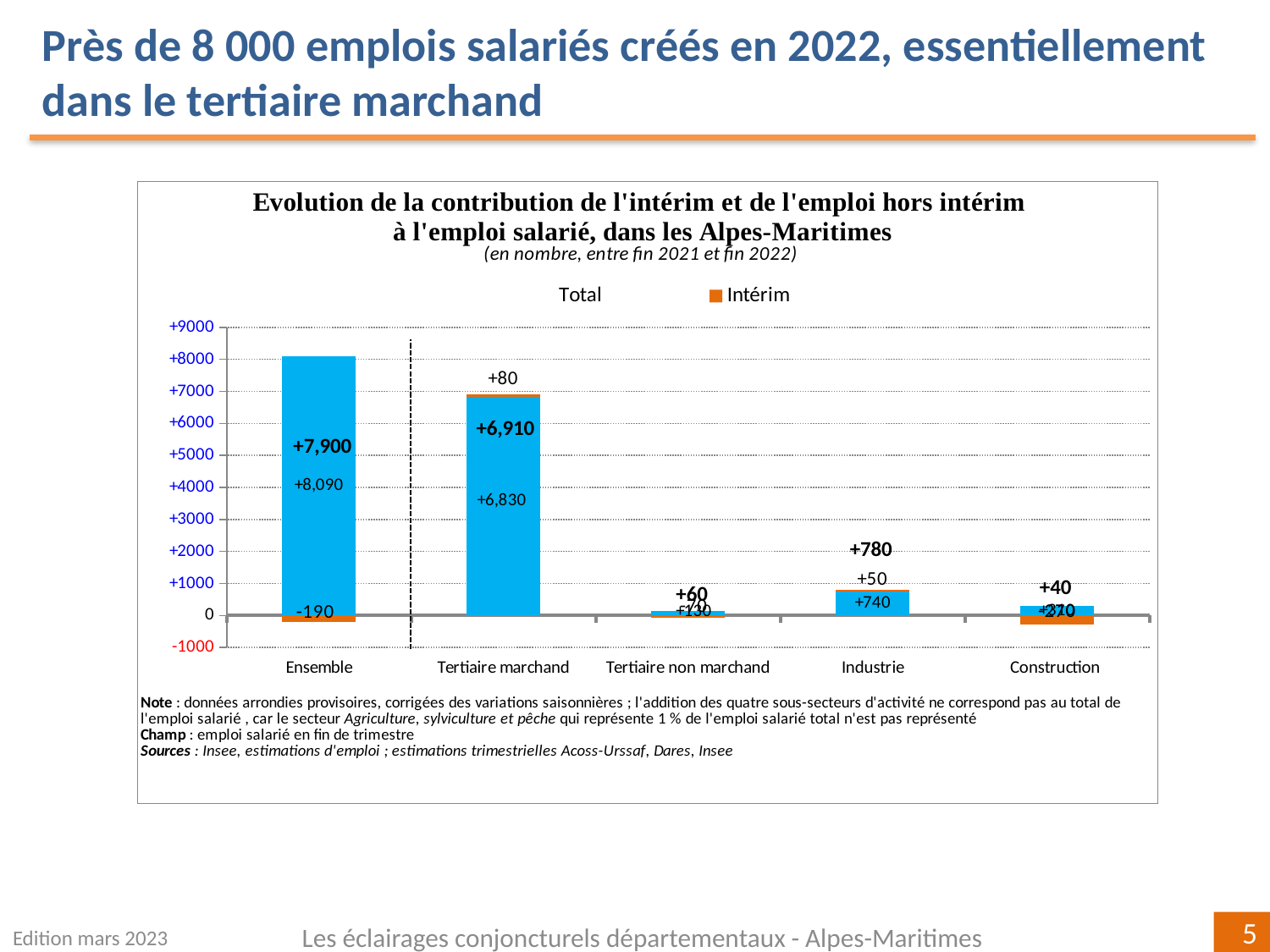
What is the Intérim value shown for Ensemble? -190 Which has the larger total value, Industrie or Construction? Industrie How many categories are shown along the x axis of the chart? 5 How many series does the chart legend list? 2 What is the difference between the total value for Ensemble (+7,900) and the total value for Tertiaire marchand (+6,910)? 990 What is the total value (bold label) shown for Industrie? +780 What kind of chart is shown on the slide? bar chart Among the four sub-sectors (excluding Ensemble), which has the highest total value? Tertiaire marchand What is the Intérim value shown for Industrie? +50 What is the total value (bold label) shown for Ensemble? +7,900 What is the total value (bold label) shown for Tertiaire marchand? +6,910 What is the Intérim value shown for Tertiaire marchand? +80